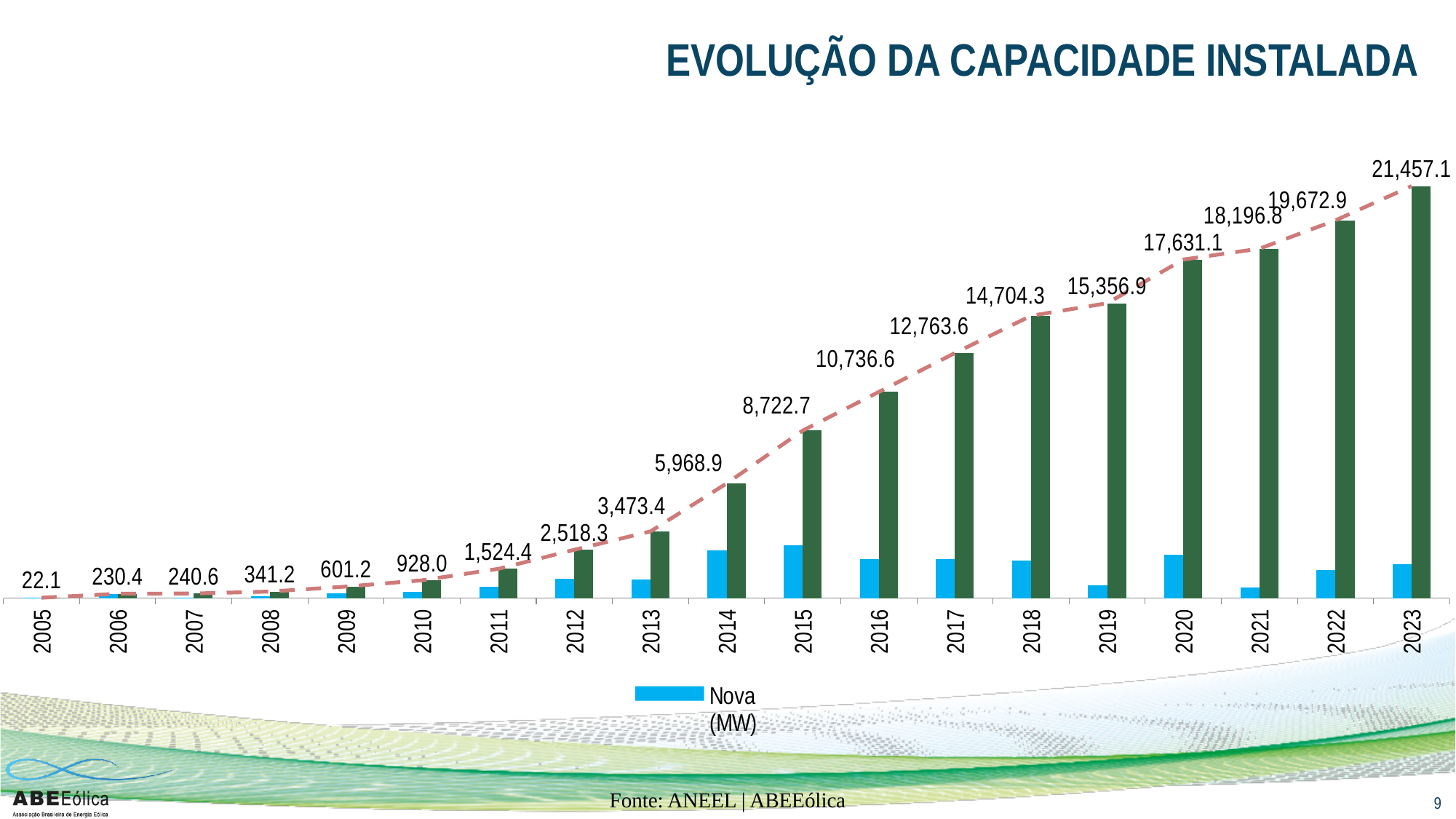
Which year has the lowest labelled value? 2005 What is the labelled value for 2010? 928.0 What is the difference between the labelled values for 2014 and 2013? 2,495.5 What is the labelled value for 2023? 21,457.1 What is the title of the slide's chart? EVOLUÇÃO DA CAPACIDADE INSTALADA Which year has the highest labelled value? 2023 Which is larger, the labelled value for 2017 or for 2016? 2017 How many years are shown on the x axis? 19 What is the difference between the labelled values for 2023 and 2022? 1,784.2 What kind of chart is this? Combination bar and line chart Do the labelled values rise or fall from 2005 to 2023? Rise What is the labelled value for 2014? 5,968.9